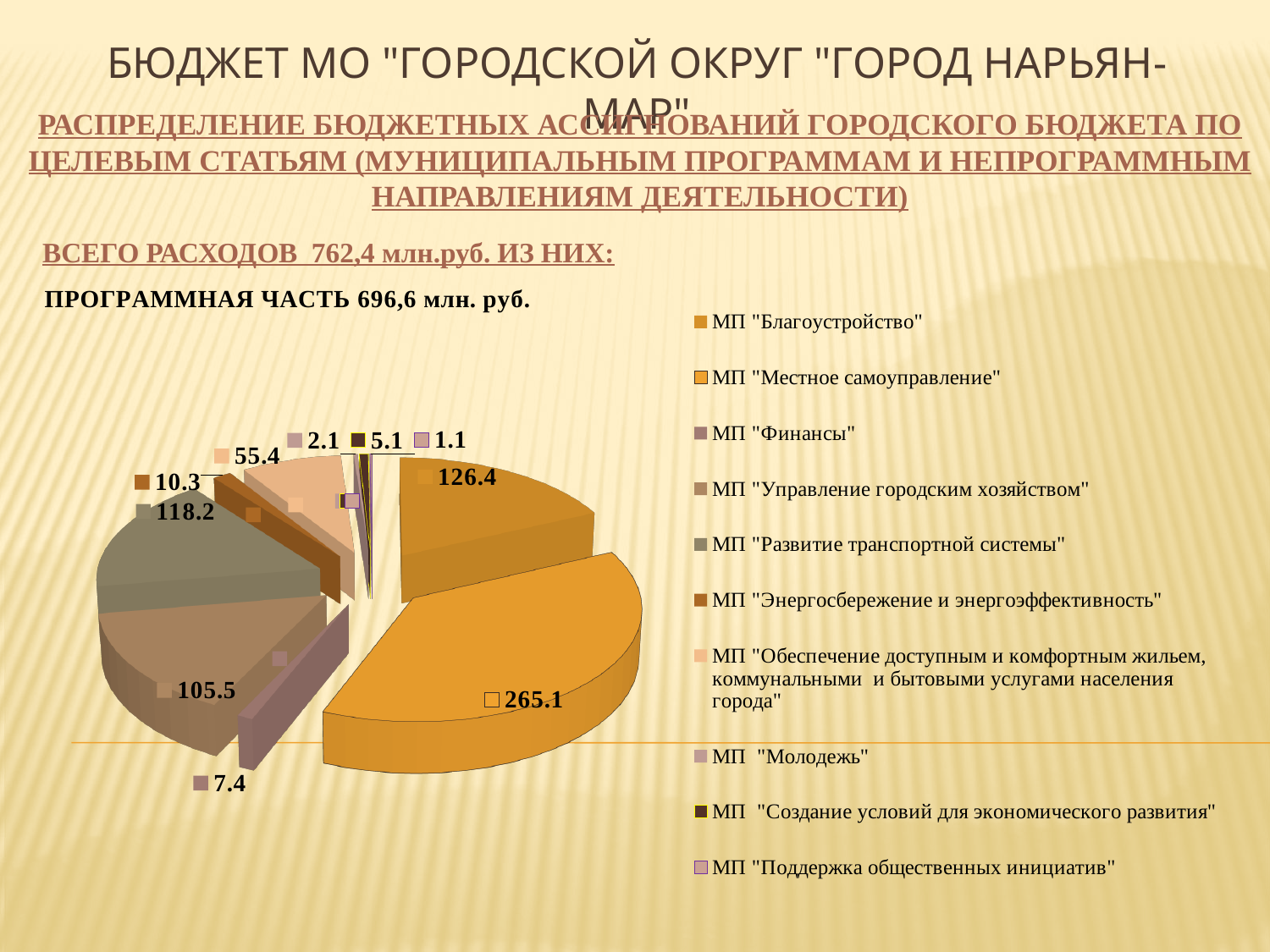
What type of chart is shown on the slide? pie chart How many entries does the chart legend list? 10 What value is shown for МП "Развитие транспортной системы"? 118.2 What is the value of the largest slice in the pie chart? 265.1 Which legend entry is listed last in the chart legend? МП "Поддержка общественных инициатив" Which is larger: the slice labelled 118.2 or the slice labelled 105.5? 118.2 What value is shown for МП "Благоустройство"? 126.4 What is the difference between the slice labelled 265.1 and the slice labelled 126.4? 138.7 What total for the programme part (ПРОГРАММНАЯ ЧАСТЬ) is stated above the chart? 696,6 млн. руб. What is the difference between the slices labelled 10.3 and 7.4? 2.9 What value is shown for МП "Обеспечение доступным и комфортным жильем, коммунальными и бытовыми услугами населения города"? 55.4 What is the value of the smallest slice in the pie chart? 1.1